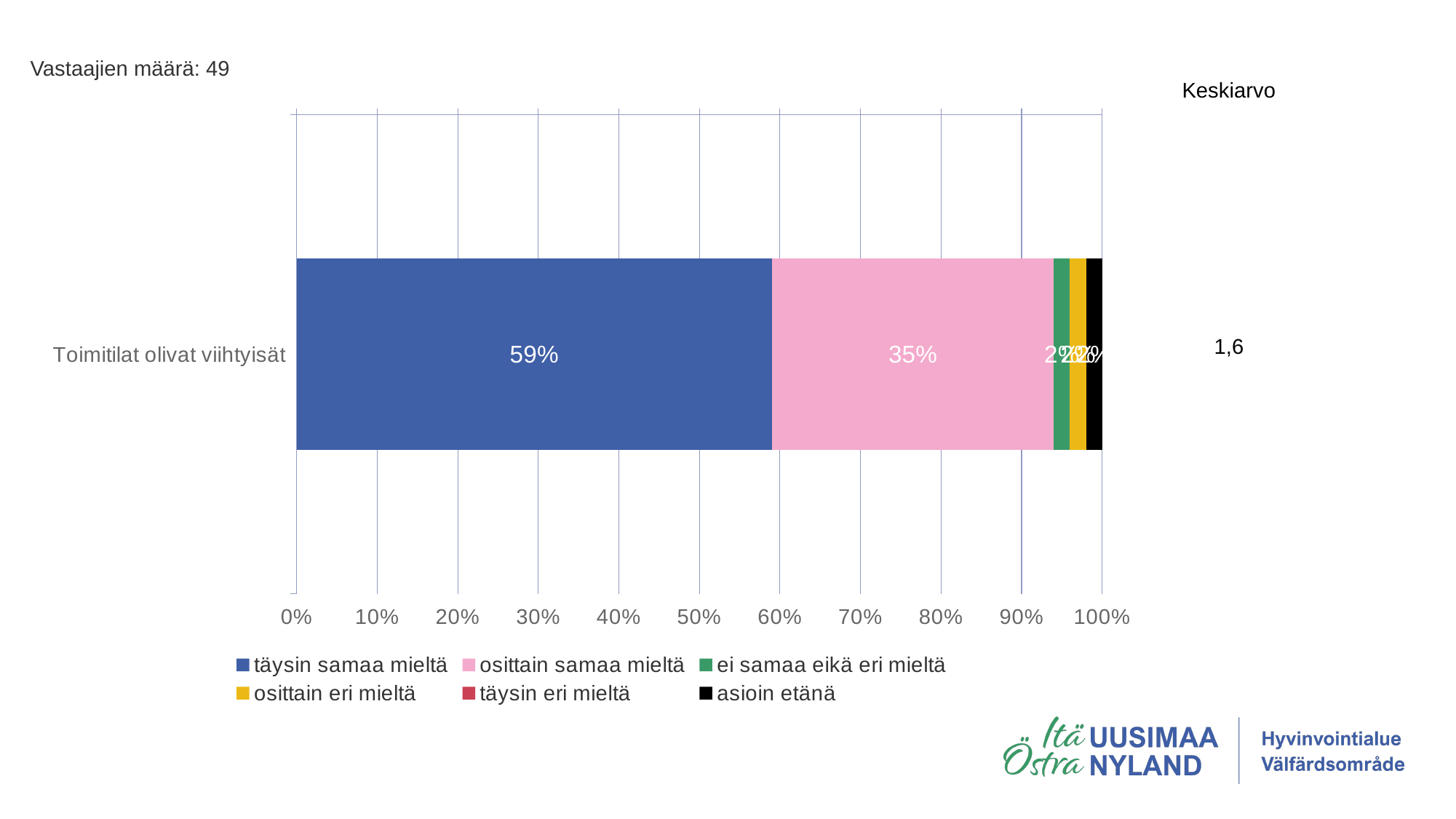
What is the difference in percentage points between "täysin samaa mieltä" and "osittain samaa mieltä" for "Toimitilat olivat viihtyisät"? 24 percentage points Which is larger for "Toimitilat olivat viihtyisät": the share of "täysin samaa mieltä" or "osittain samaa mieltä"? täysin samaa mieltä How many series does the legend list? 6 What kind of chart is shown on the slide? Stacked bar chart Is the share of "osittain samaa mieltä" greater or less than 40%? less Which response option has the largest share of the bar for "Toimitilat olivat viihtyisät"? täysin samaa mieltä What colour represents "täysin samaa mieltä" in the chart? Blue What is the Keskiarvo (average) shown for "Toimitilat olivat viihtyisät"? 1,6 Is the share of "täysin samaa mieltä" greater or less than 50%? greater How many categories (statements) are plotted on the chart? 1 What percentage of respondents answered "osittain samaa mieltä" for "Toimitilat olivat viihtyisät"? 35% What percentage of respondents answered "täysin samaa mieltä" for "Toimitilat olivat viihtyisät"? 59%